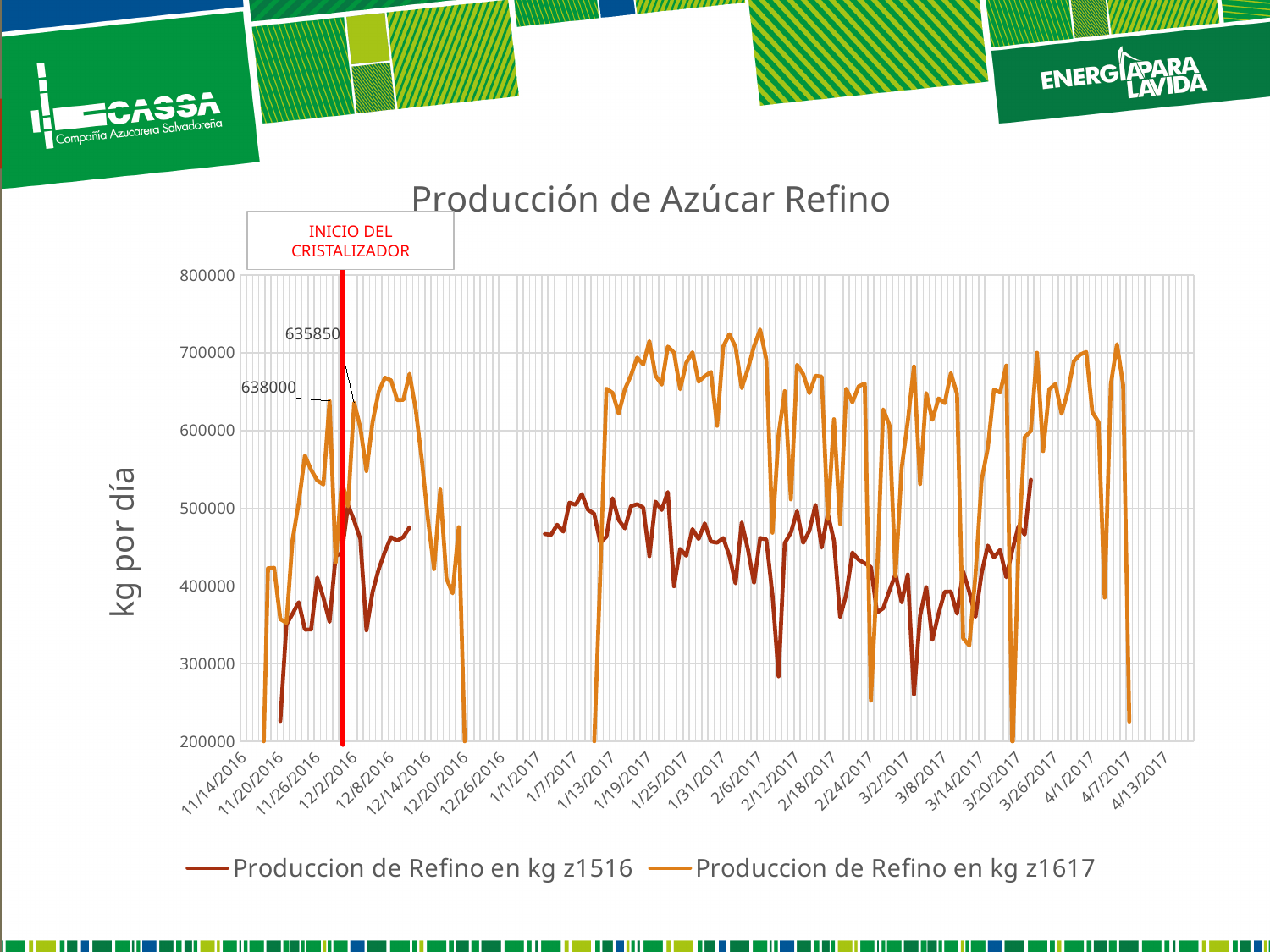
What is the difference between the two printed data labels, 638000 and 635850? 2150 What kind of chart is shown on the slide? Line chart What value is printed on the leftmost data label of the chart? 638000 Which series is generally higher during January 2017, z1516 or z1617? Produccion de Refino en kg z1617 Which of the two printed data labels is larger, 638000 or 635850? 638000 Is the lowest dip of the 'Produccion de Refino en kg z1516' series near 3/2/2017 greater or less than 300000? less How many series does the chart legend list? 2 Is the peak of the 'Produccion de Refino en kg z1617' series near 2/6/2017 greater or less than 700000? greater What is the highest value shown on the vertical axis? 800000 What is the title of the chart? Producción de Azúcar Refino What value is printed on the data label immediately to the left of the red vertical line? 635850 What is the label on the vertical axis of the chart? kg por día